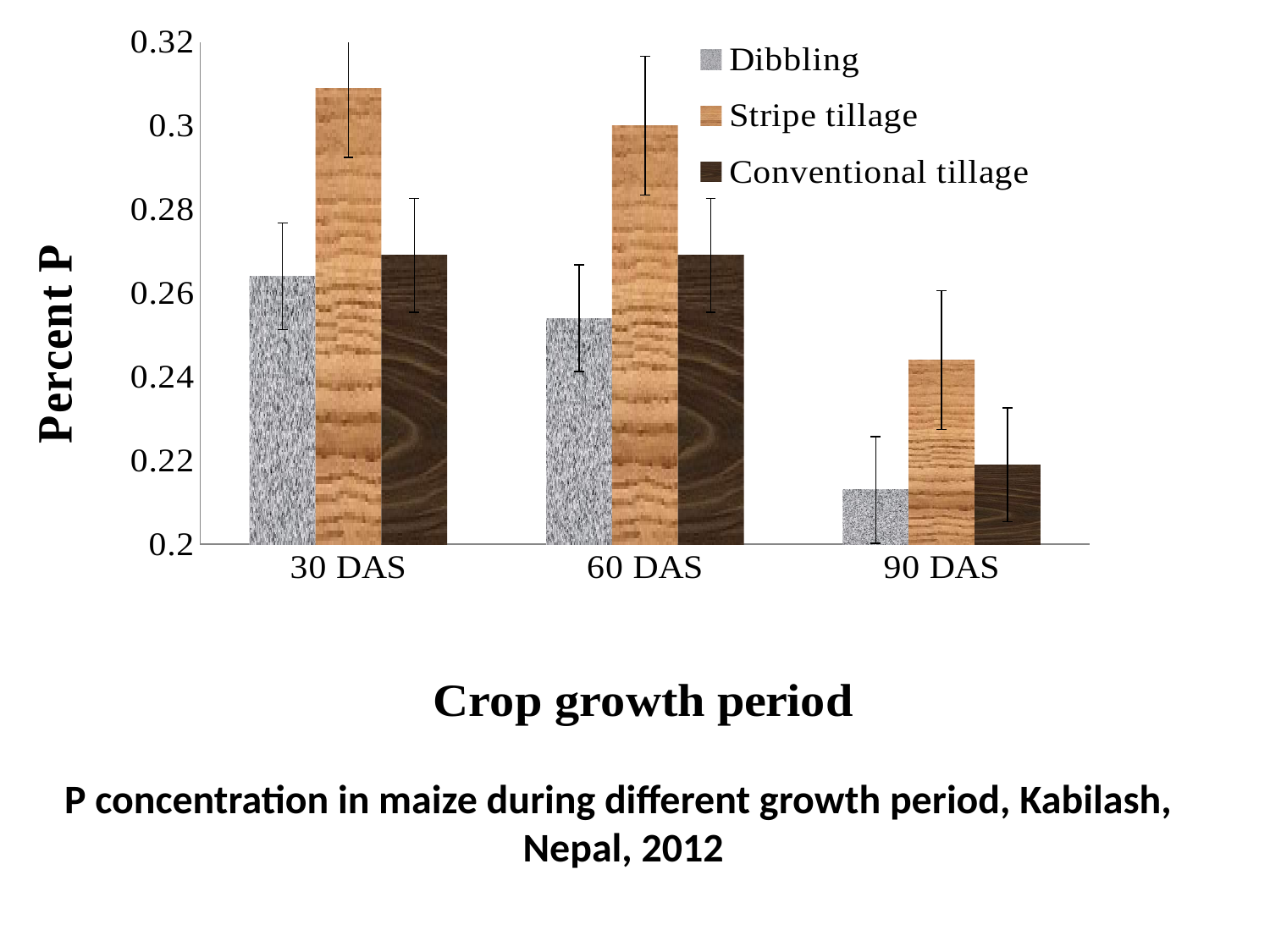
Is the Percent P for Dibbling at 60 DAS greater or less than 0.26? less Which series has the highest Percent P at 30 DAS? Stripe tillage Does the Percent P for Dibbling rise or fall from 30 DAS to 90 DAS? fall How many crop growth periods are shown on the x axis? 3 How many series does the legend list? 3 What is the title of the y axis? Percent P What kind of chart is shown on the slide? bar chart Which series has the highest Percent P at 60 DAS? Stripe tillage Is the Percent P for Stripe tillage at 30 DAS greater or less than 0.3? greater At 60 DAS, which is larger: the Percent P for Dibbling or for Conventional tillage? Conventional tillage Which series has the lowest Percent P at 90 DAS? Dibbling Is the Percent P for Dibbling at 90 DAS greater or less than 0.22? less